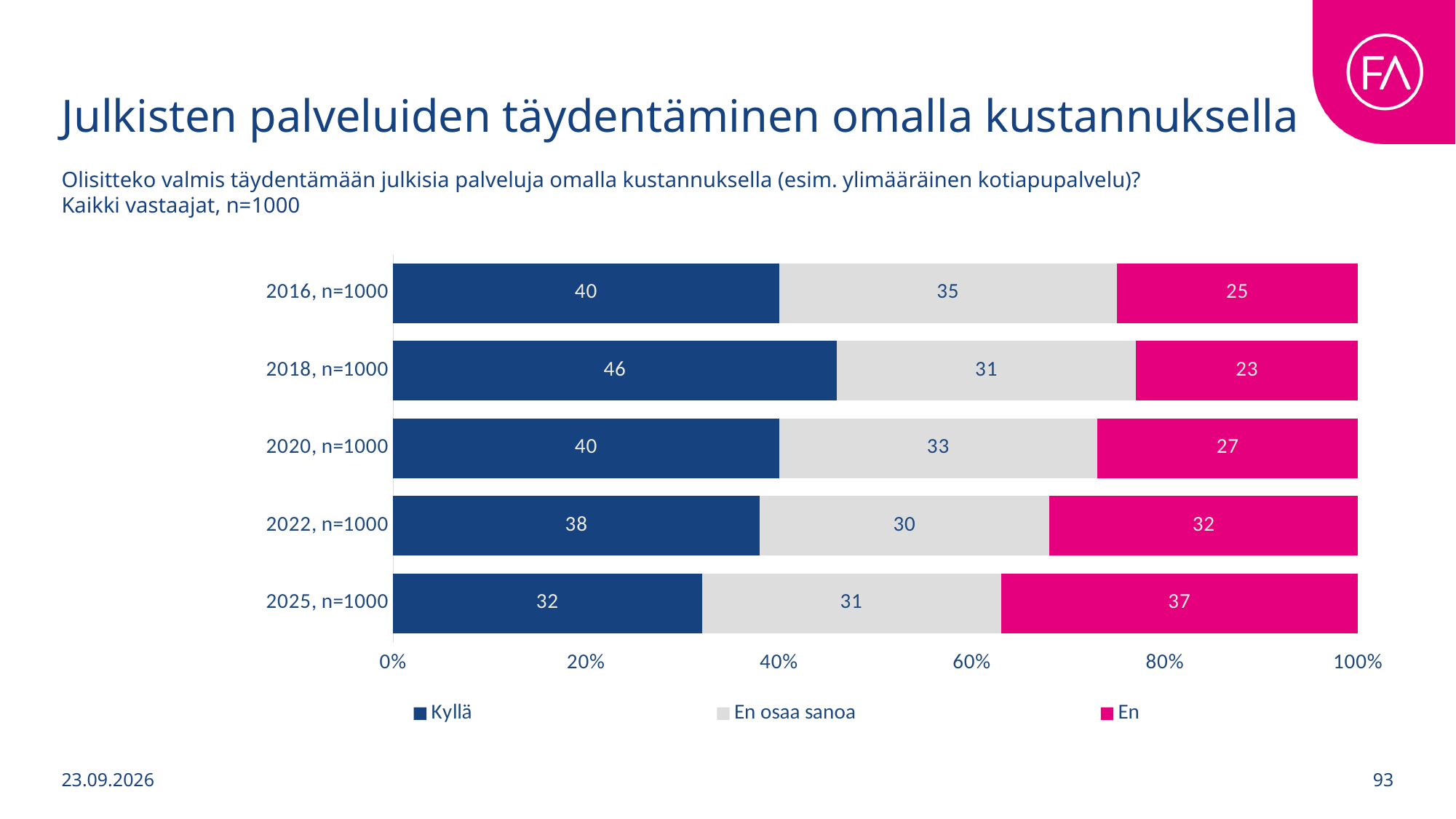
What is the total of the stacked bar for 2020, n=1000? 100 Which year has the highest value for Kyllä? 2018, n=1000 What is the value for Kyllä in 2018, n=1000? 46 Does the En value rise or fall from 2020, n=1000 to 2025, n=1000? Rise What is the value for En in 2025, n=1000? 37 What is the value for En osaa sanoa in 2016, n=1000? 35 Which is larger in 2022, n=1000: the Kyllä value or the En value? Kyllä How many series does the legend list? 3 How many year categories are shown on the chart? 5 What is the difference between the En value in 2025, n=1000 and in 2016, n=1000? 12 What kind of chart is shown on the slide? Stacked bar chart Which year has the lowest value for En? 2018, n=1000